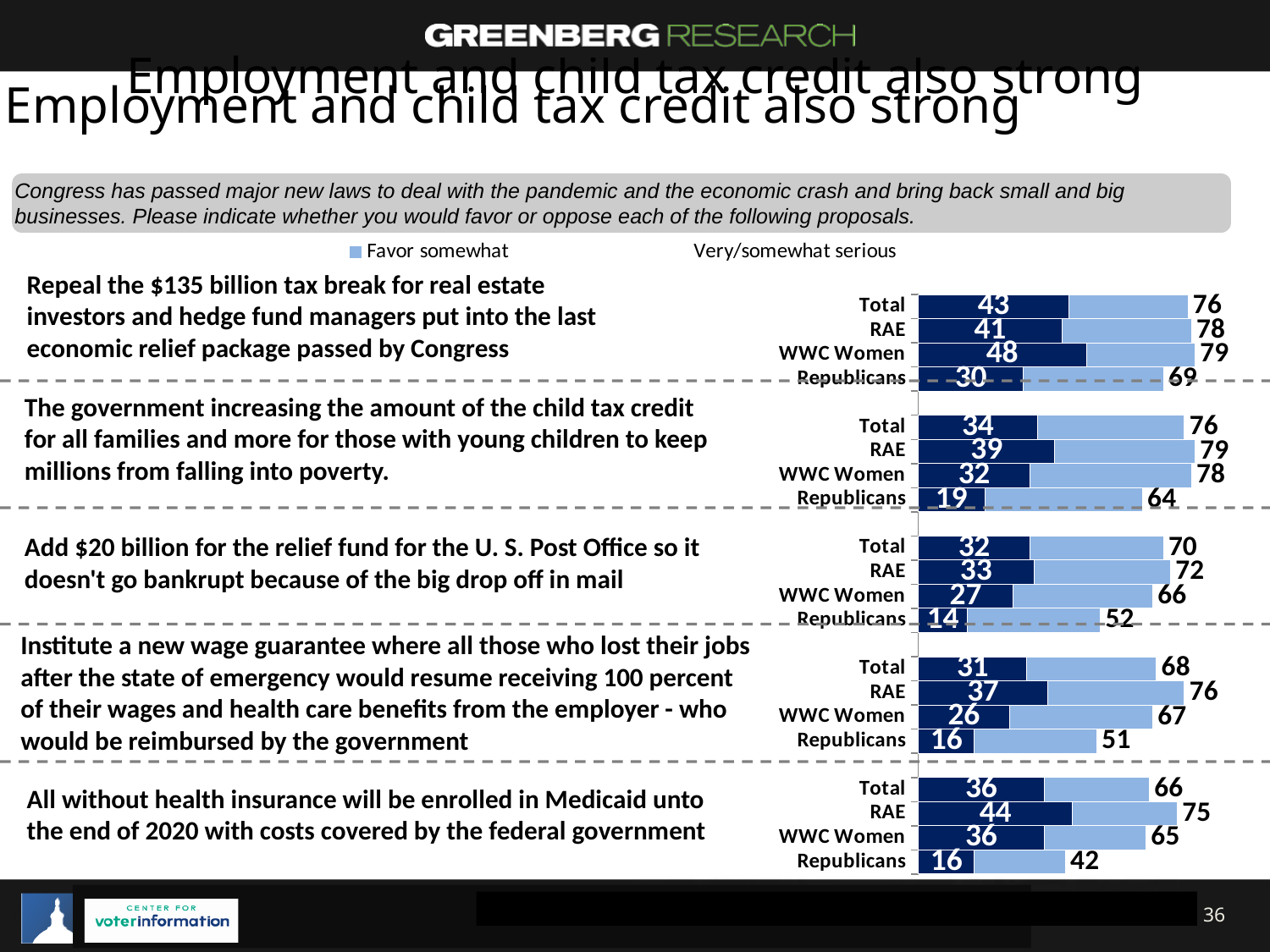
In the bottom chart (enrolling all without health insurance in Medicaid), what is the total value at the end of the bar for Republicans? 42 How many categories are plotted in each of the bar charts on the slide? 4 In the second chart (increasing the child tax credit), what is the dark blue segment value for RAE? 39 In the fourth chart (new wage guarantee), which category has the highest total value at the end of its bar? RAE In the second chart (increasing the child tax credit), which category has the lowest total value at the end of its bar? Republicans In the third chart ($20 billion for the U.S. Post Office), what is the difference between the total values for RAE and Republicans? 20 What kind of chart is used to display the data on this slide? Bar chart In the third chart ($20 billion for the U.S. Post Office), what is the total value at the end of the bar for Total? 70 In the top chart (repeal the $135 billion tax break), what is the value of the dark blue segment for WWC Women? 48 In the top chart (repeal the $135 billion tax break), what is the total value shown at the end of the bar for Republicans? 69 In the bottom chart (enrolling all without health insurance in Medicaid), is the total value for RAE or for Total larger? RAE In the fourth chart (new wage guarantee), what is the dark blue segment value for WWC Women? 26